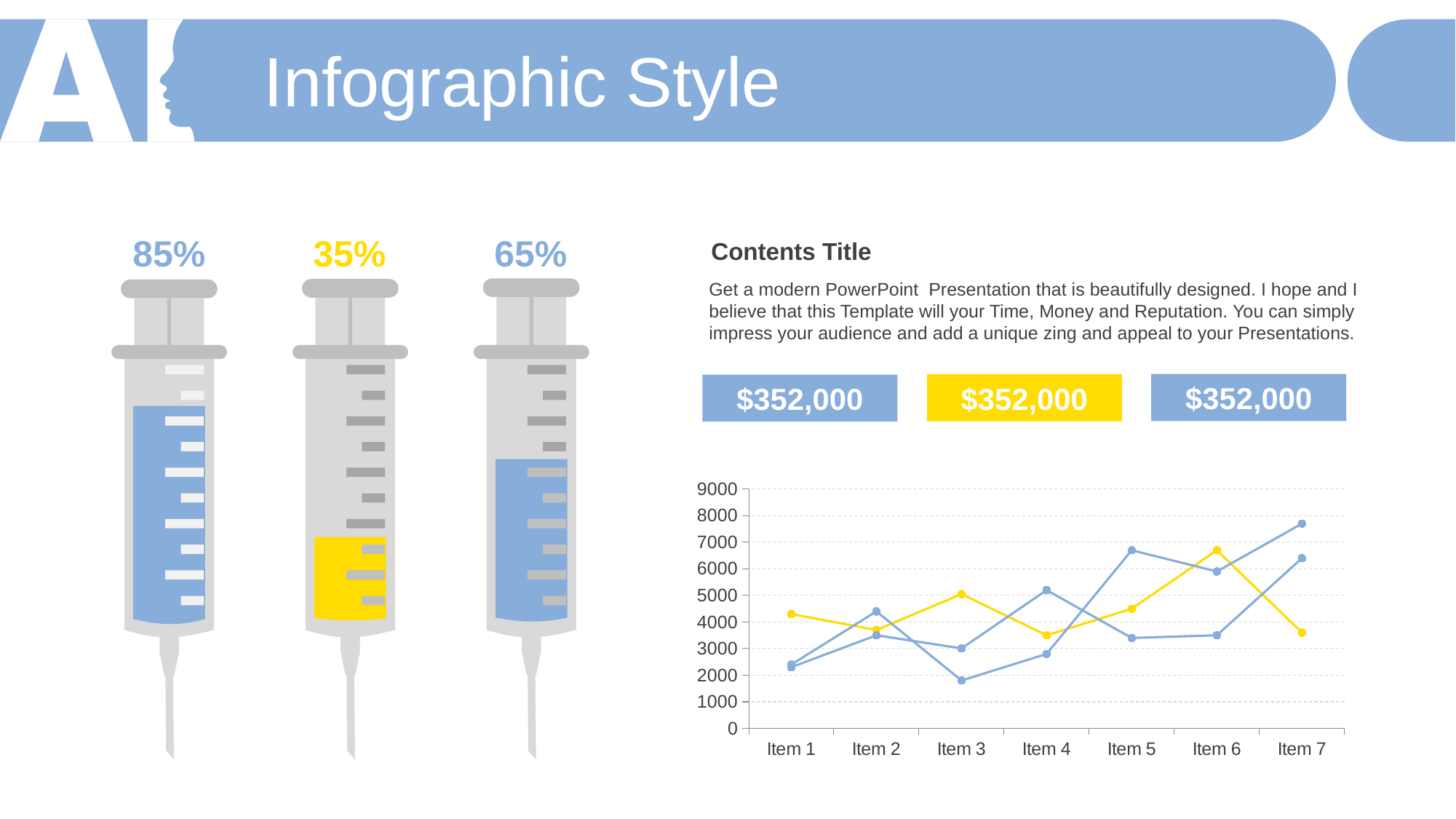
At which item does the line chart reach its lowest plotted point? Item 3 Is the value of the yellow line at Item 6 greater or less than 6000? greater How many lines are plotted in the line chart? 3 What kind of chart is shown on the slide? line chart Is the value of the yellow line at Item 1 greater or less than 5000? less Is the value of the yellow line at Item 3 greater or less than 4000? greater How many items are plotted along the x axis of the line chart? 7 What is the highest value shown on the y axis of the line chart? 9000 At which item does the line chart reach its highest plotted point? Item 7